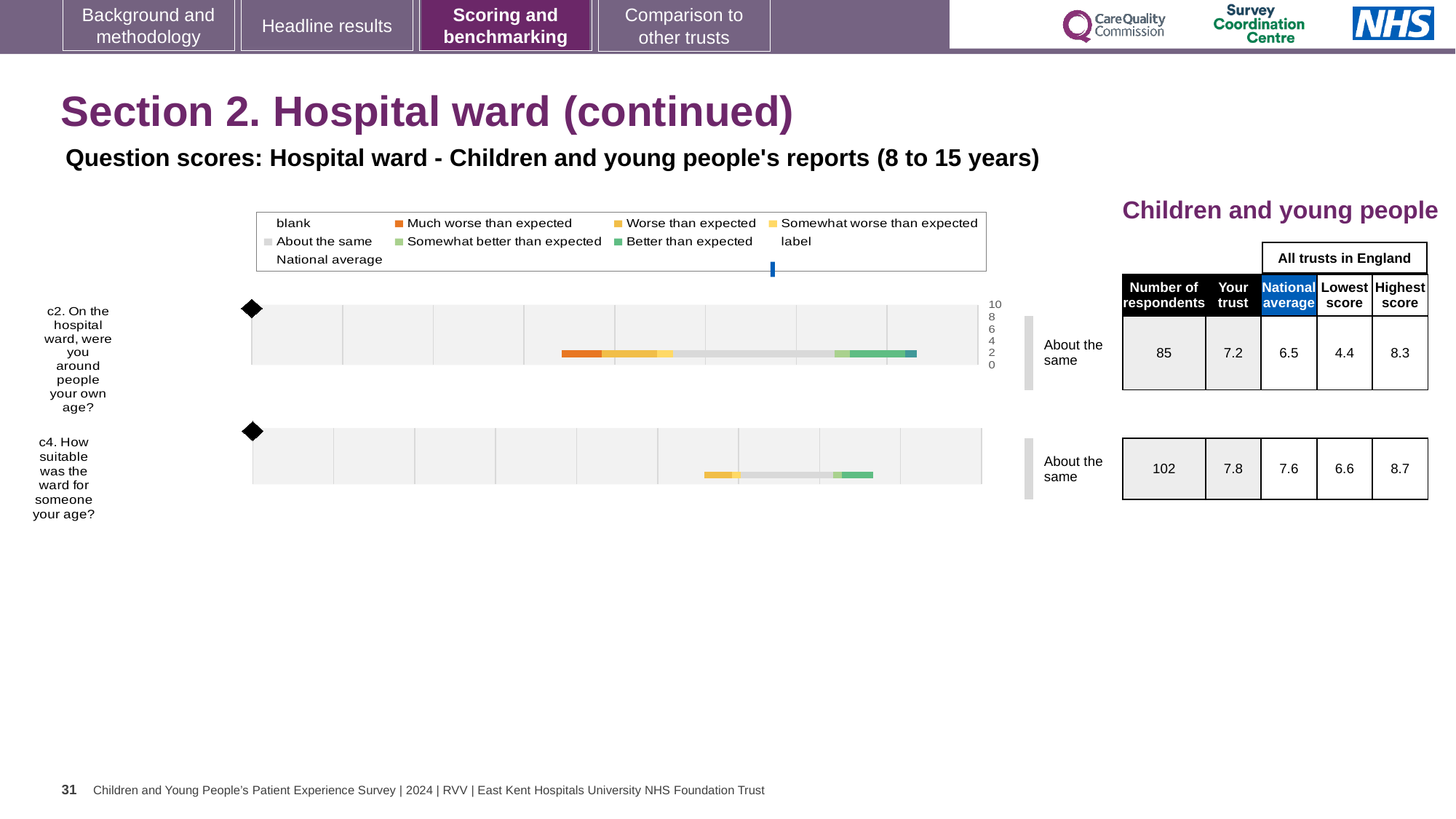
Which question has the higher 'Your trust' score, c2 or c4? c4 How many respondents answered c4? 102 What is the lowest score among all trusts in England for c2? 4.4 What colour represents 'Much worse than expected' in the legend? orange What is the national average score for c2? 6.5 What is the difference between the highest and lowest scores for c4? 2.1 What kind of chart is used to show the question scores for c2 and c4? bar chart What is the 'Your trust' score for c2 (On the hospital ward, were you around people your own age?)? 7.2 How many questions are plotted on the slide? 2 By how much does the trust's score for c2 exceed the national average? 0.7 What benchmark category is shown for c2? About the same What is the 'Your trust' score for c4 (How suitable was the ward for someone your age?)? 7.8